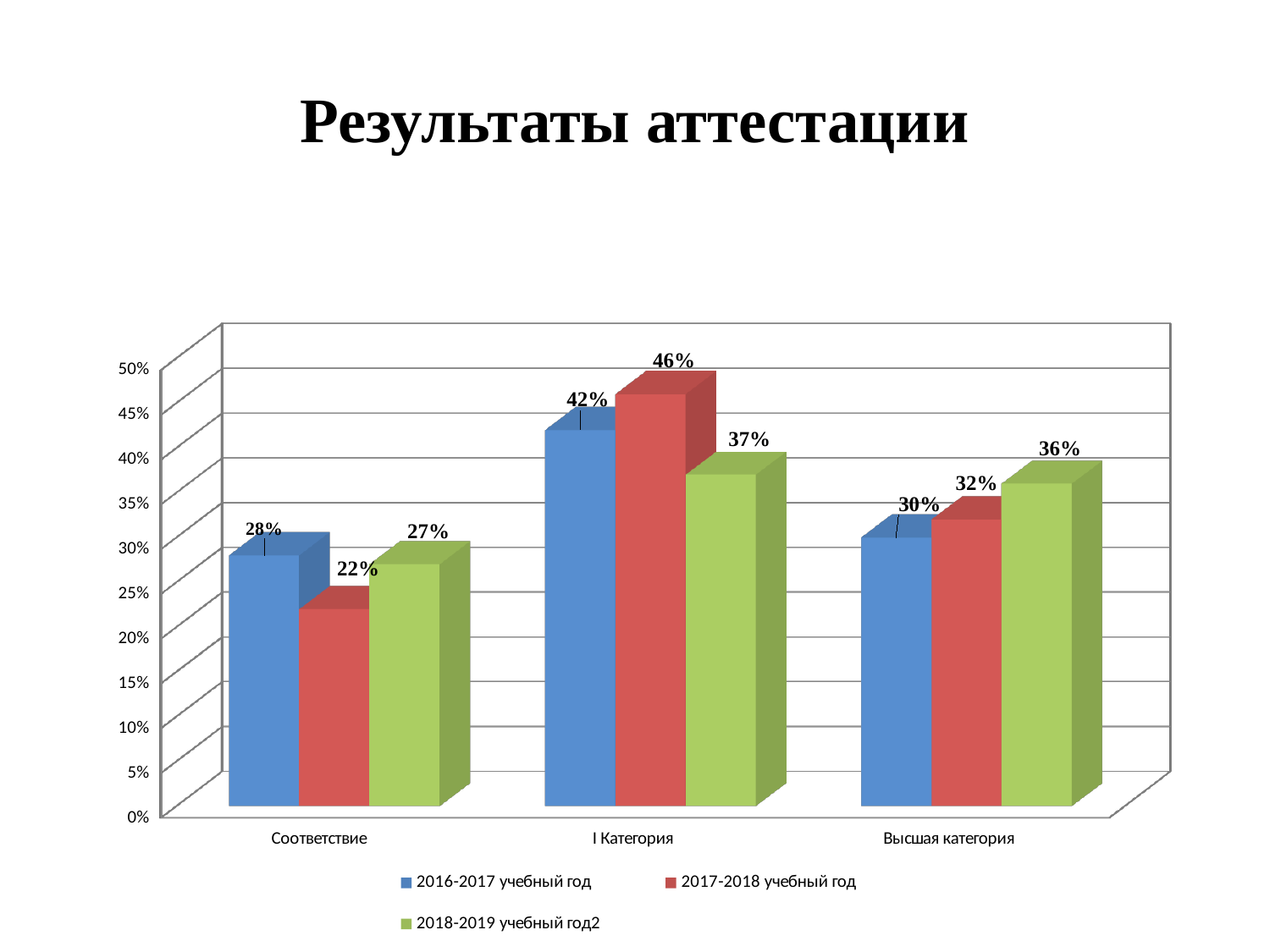
How many categories are shown on the x axis? 3 What is the title of the chart? Результаты аттестации What is the value for 2017-2018 учебный год in the I Категория category? 46% Is the value for 2018-2019 учебный год2 in the I Категория category greater or less than 35%? greater What is the value for 2018-2019 учебный год2 in the Высшая категория category? 36% What is the value for 2016-2017 учебный год in the Соответствие category? 28% How many series does the legend list? 3 What kind of chart is shown on the slide? bar chart Which category has the highest value for 2016-2017 учебный год? I Категория What is the difference between the 2017-2018 учебный год and 2016-2017 учебный год values in the I Категория category? 4% Which category has the lowest value for 2017-2018 учебный год? Соответствие Which is larger in the Высшая категория category: the value for 2016-2017 учебный год or for 2018-2019 учебный год2? 2018-2019 учебный год2